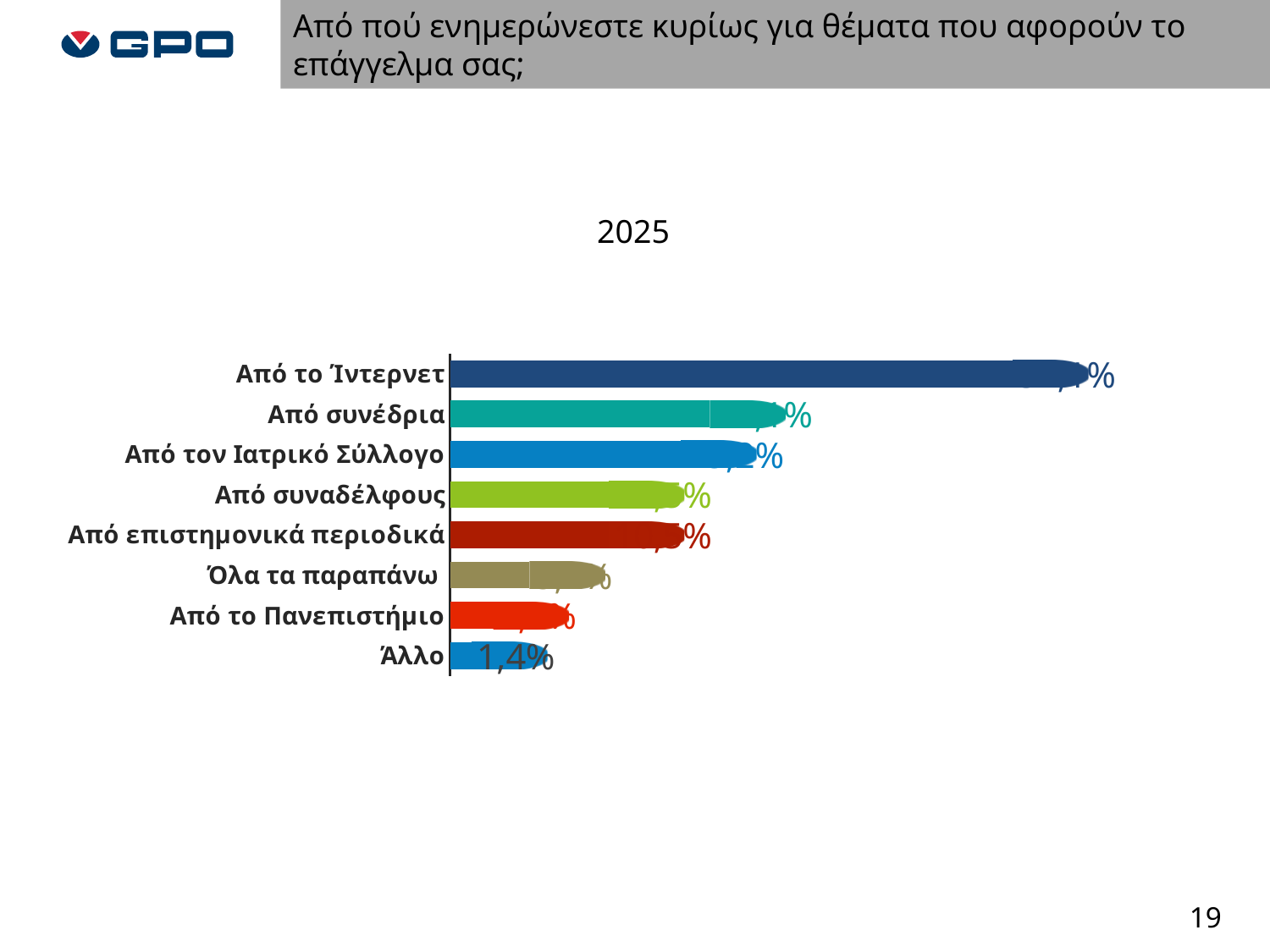
Which is larger, the value for Από το Ίντερνετ or the value for Από συνέδρια? Από το Ίντερνετ Which category is listed at the top of the chart? Από το Ίντερνετ What kind of chart is shown on the slide? bar chart What is the value shown for Άλλο? 1,4% What is the title shown above the chart? 2025 How many categories are plotted in the chart? 8 Which is larger, the value for Από συνέδρια or the value for Από συναδέλφους? Από συνέδρια Which category has the highest value in the chart? Από το Ίντερνετ Which is larger, the value for Από τον Ιατρικό Σύλλογο or the value for Από επιστημονικά περιοδικά? Από τον Ιατρικό Σύλλογο Which category has the lowest value in the chart? Άλλο